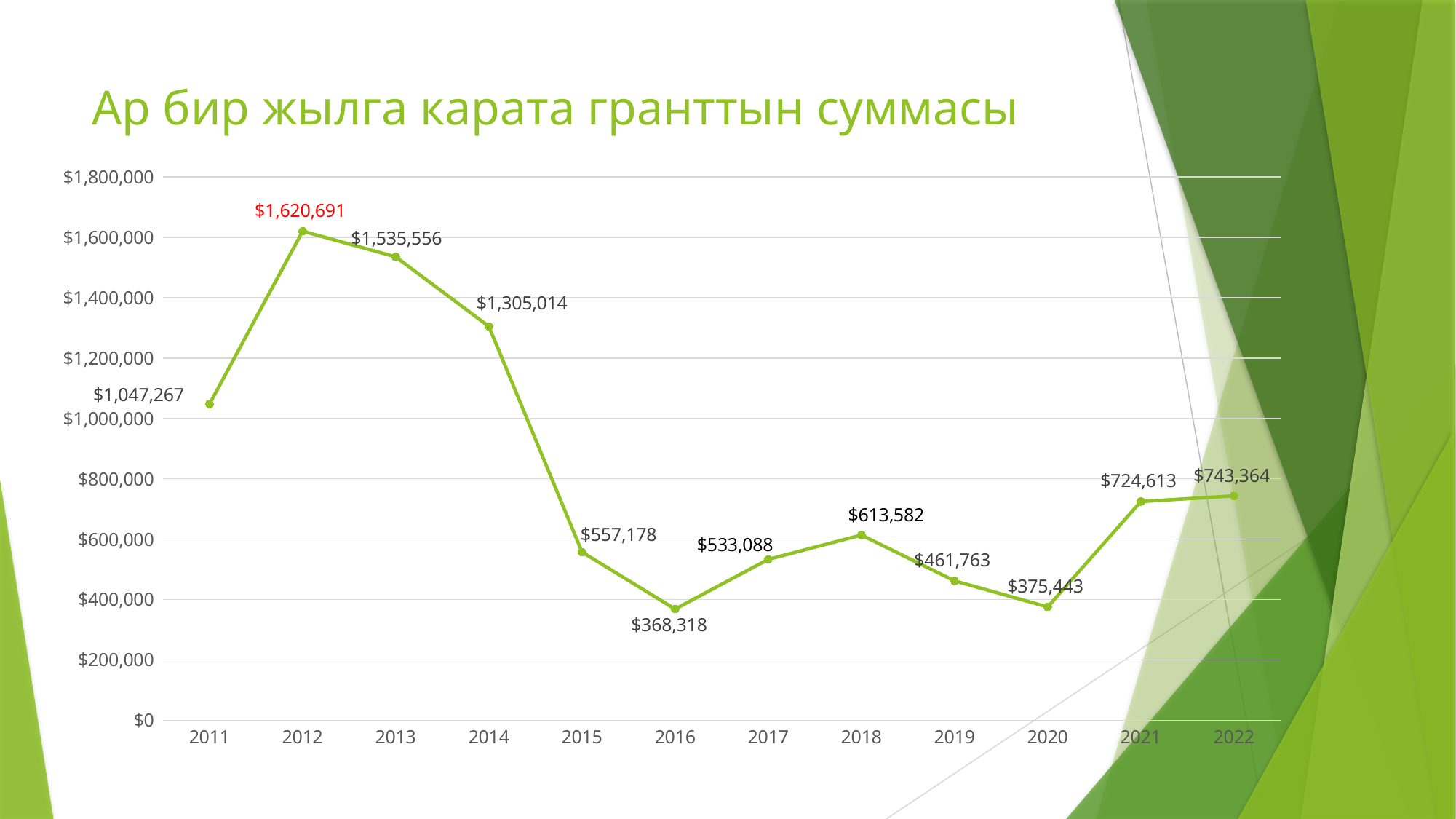
What kind of chart is shown on the slide? line chart What is the difference between the values for 2012 and 2011? $573,424 What is the value for 2012? $1,620,691 What is the value for 2022? $743,364 What is the difference between the values for 2018 and 2017? $80,494 How many years are plotted on the x axis? 12 Is the value for 2014 greater or less than $1,200,000? greater What is the value for 2016? $368,318 Which is larger, the value for 2019 or the value for 2020? 2019 Which year has the highest value? 2012 Which year has the lowest value? 2016 Do the values rise or fall from 2012 to 2016? fall